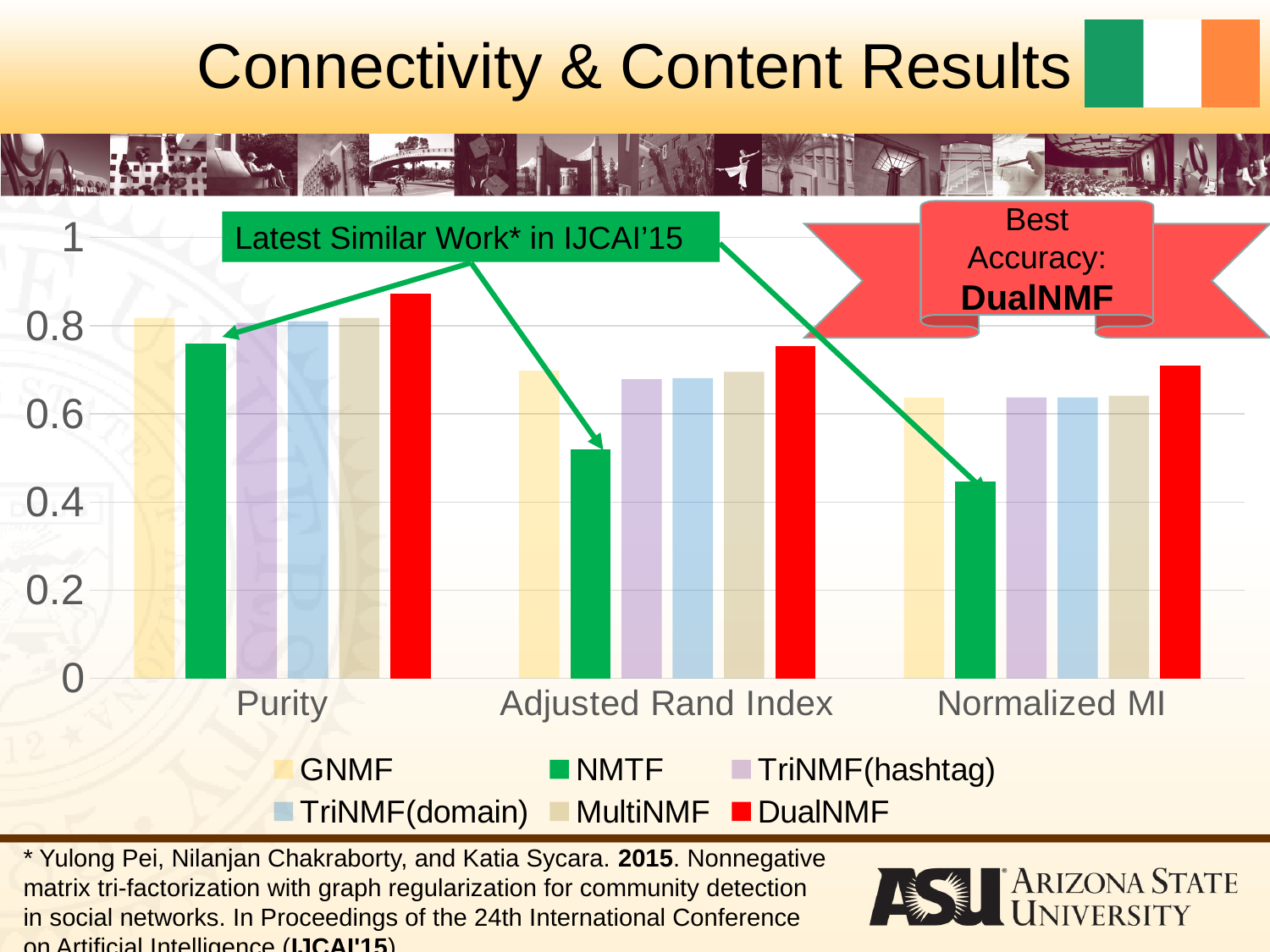
Which series has the highest value for Normalized MI? DualNMF Which series has the highest value for Purity? DualNMF Which series has the lowest value for Normalized MI? NMTF Is the value for DualNMF on Purity greater or less than 0.8? greater Is the value for NMTF on Normalized MI greater or less than 0.6? less Which series is shown in red in the chart's legend? DualNMF Is the value for NMTF on Adjusted Rand Index greater or less than 0.6? less Which series has the lowest value for Adjusted Rand Index? NMTF How many series does the chart's legend list? 6 How many categories are shown on the x axis of the chart? 3 Which is larger: the DualNMF value for Purity or the DualNMF value for Normalized MI? Purity What kind of chart is shown on the slide? bar chart